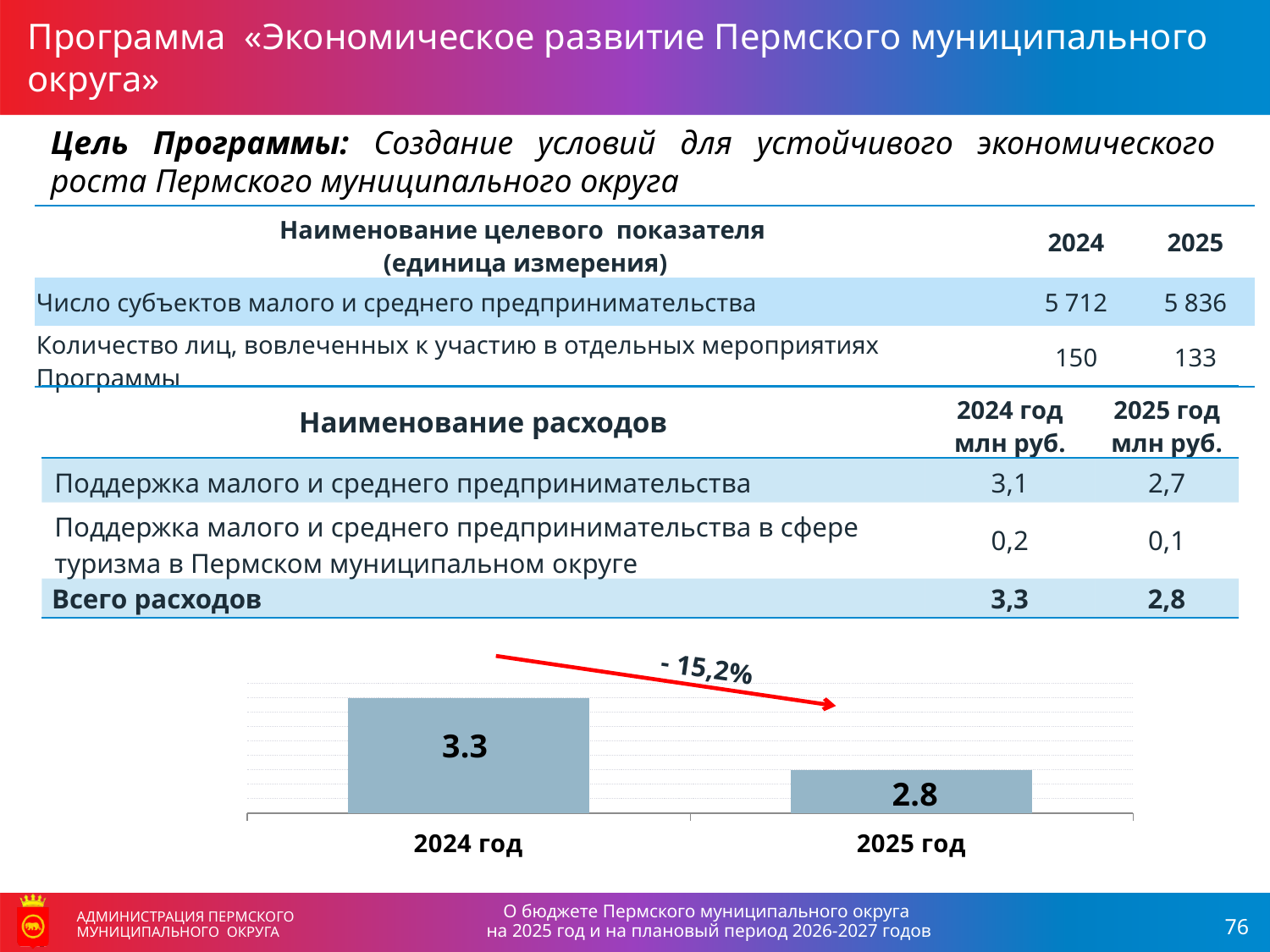
What are the two category labels on the x axis of the bar chart? 2024 год and 2025 год Which year has the lowest bar in the chart? 2025 год What is the value shown for 2025 год in the bar chart? 2.8 What percentage change is annotated above the bars in the chart? - 15,2% What is the difference between the values for 2024 год and 2025 год in the bar chart? 0.5 What kind of chart is shown at the bottom of the slide? Bar chart Which is larger in the bar chart, the value for 2024 год or for 2025 год? 2024 год How many bars are plotted in the chart? 2 Which year has the highest bar in the chart? 2024 год What is the value shown for 2024 год in the bar chart? 3.3 Do the values in the bar chart rise or fall from 2024 год to 2025 год? Fall